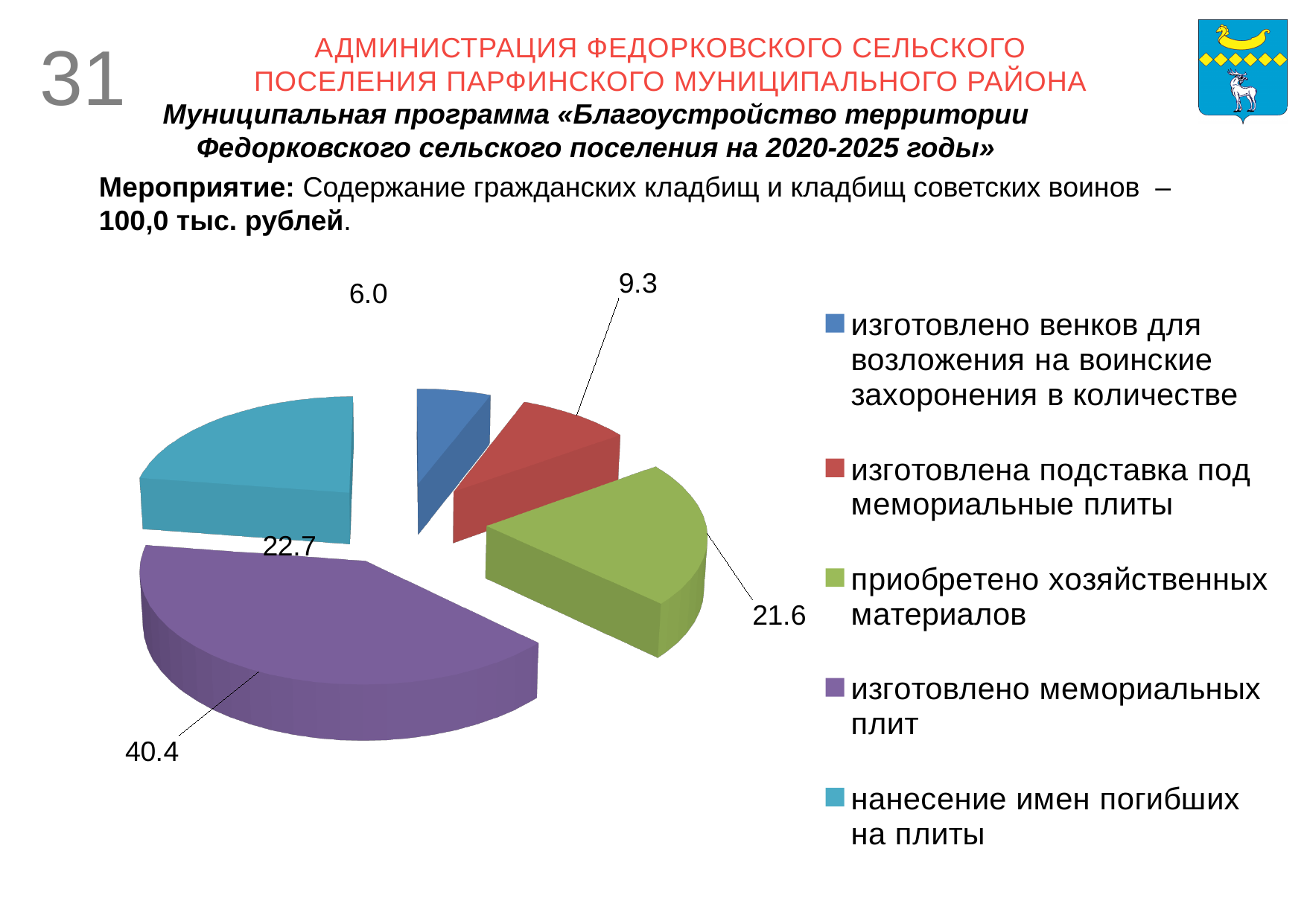
How many slices does the pie chart have? 5 Which category has the largest slice of the pie? изготовлено мемориальных плит Which category has the smallest slice of the pie? изготовлено венков для возложения на воинские захоронения в количестве What is the difference between the values for «изготовлено мемориальных плит» and «изготовлена подставка под мемориальные плиты»? 31.1 How many entries does the legend list? 5 What is the value for «изготовлено мемориальных плит»? 40.4 What is the value for «приобретено хозяйственных материалов»? 21.6 What colour is the slice for «изготовлена подставка под мемориальные плиты»? red Which is larger: the value for «нанесение имен погибших на плиты» or for «приобретено хозяйственных материалов»? нанесение имен погибших на плиты What type of chart is shown on the slide? pie chart What is the value for «изготовлено венков для возложения на воинские захоронения в количестве»? 6.0 What is the value for «нанесение имен погибших на плиты»? 22.7